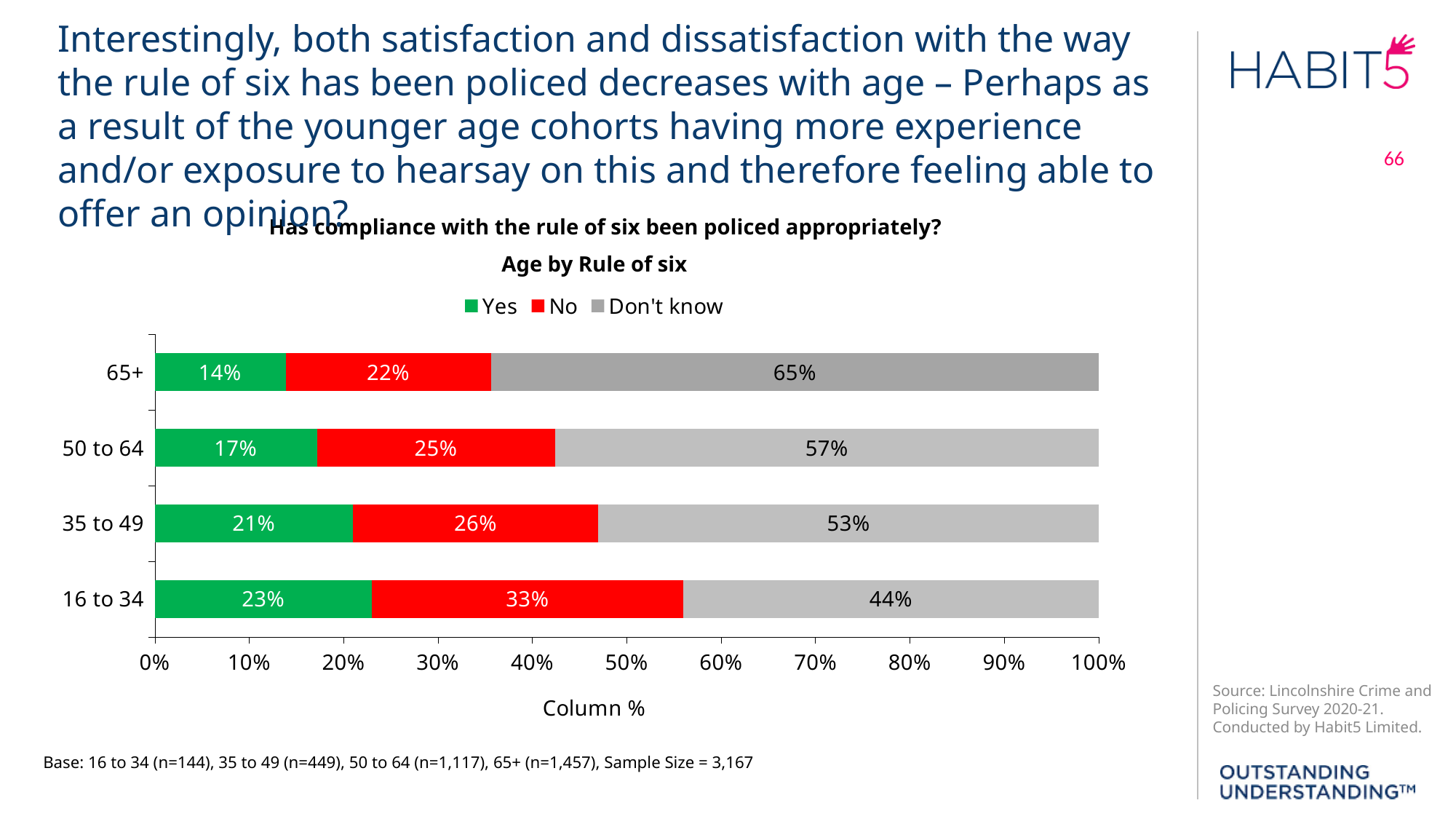
Which is larger: the 'Don't know' percentage for 35 to 49 or for 50 to 64? 50 to 64 What kind of chart is shown on the slide? Stacked bar chart How many series does the legend list? 3 Moving from the 16 to 34 group up to the 65+ group, does the 'Yes' percentage rise or fall? Fall What colour represents the 'No' series in the chart? Red What percentage of the 65+ age group answered 'Don't know'? 65% Which age group has the highest 'Yes' percentage? 16 to 34 What percentage of the 50 to 64 age group answered 'Yes'? 17% Which age group has the lowest 'Don't know' percentage? 16 to 34 How many age groups are shown in the chart? 4 What is the difference between the 'No' percentage for 16 to 34 and for 65+? 11% What percentage of the 16 to 34 age group answered 'No'? 33%